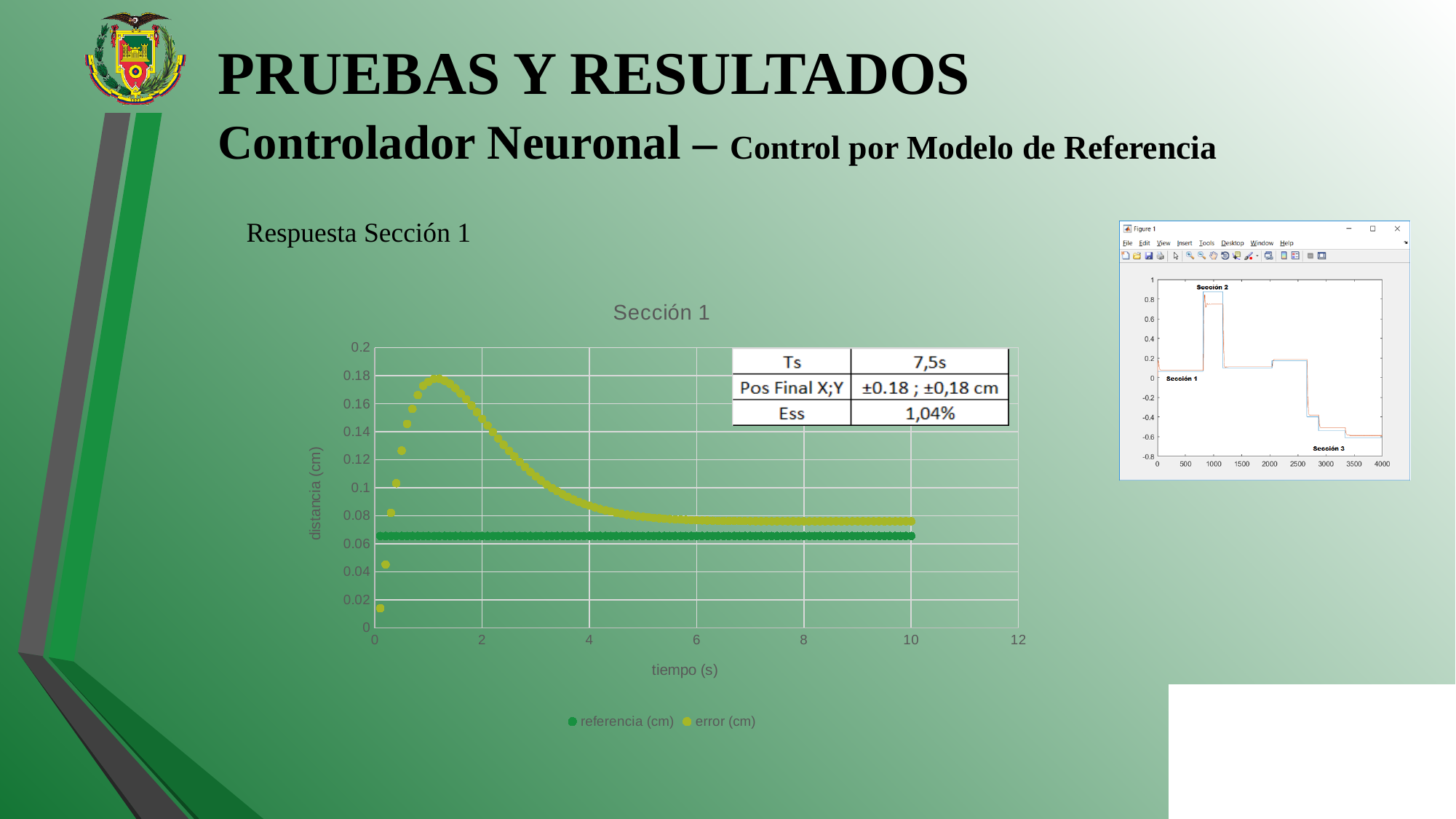
What is the title of the main chart on the slide? Sección 1 In the 'Sección 1' chart, does the error (cm) series rise or fall between 2 s and 6 s? fall In the 'Sección 1' chart, which series reaches the highest value? error (cm) What value of Ess is shown in the table inside the 'Sección 1' chart? 1,04% What kind of chart is the main 'Sección 1' chart? scatter chart What is the label of the x axis of the 'Sección 1' chart? tiempo (s) In the 'Sección 1' chart, is the value of the referencia (cm) series greater or less than 0.06? greater In the 'Sección 1' chart, is the value of the referencia (cm) series greater or less than 0.08? less What value of Ts is shown in the table inside the 'Sección 1' chart? 7,5s How many series does the legend of the 'Sección 1' chart list? 2 In the 'Sección 1' chart, at 8 s, which series has the higher value: error (cm) or referencia (cm)? error (cm) In the 'Sección 1' chart, is the peak value of the error (cm) series greater or less than 0.16? greater